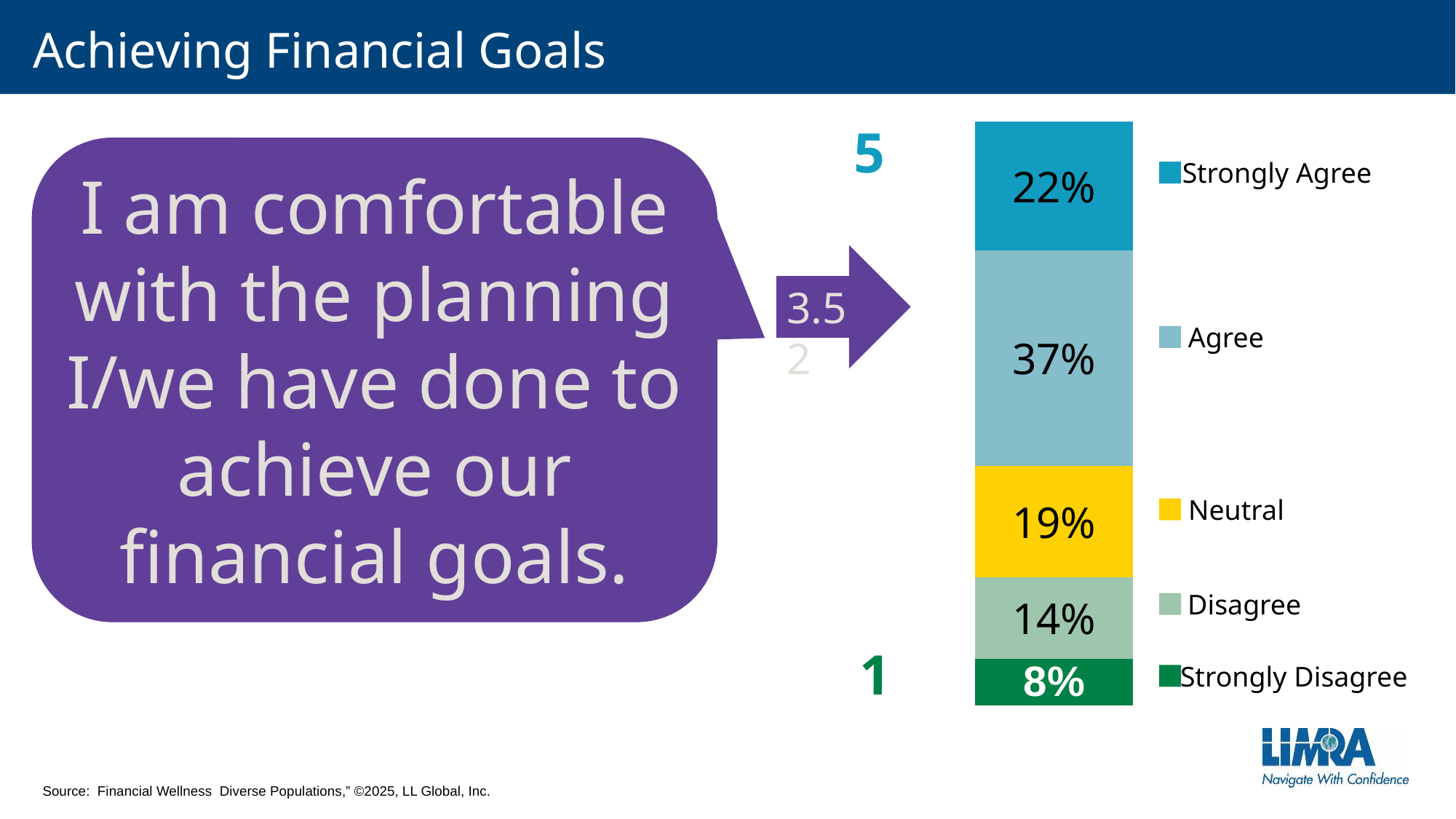
Which response category has the largest share? Agree What percentage of respondents Strongly Agree with the statement? 22% Which is larger, the Neutral share or the Disagree share? Neutral What percentage of respondents Agree with the statement? 37% Which response category has the smallest share? Strongly Disagree How many response categories does the legend list? 5 What percentage of respondents Disagree? 14% What percentage of respondents are Neutral? 19% What is the combined percentage of respondents who Agree or Strongly Agree? 59% What percentage of respondents Strongly Disagree? 8% What is the difference between the Agree and Strongly Agree percentages? 15% What kind of chart is shown on the slide? Stacked bar chart